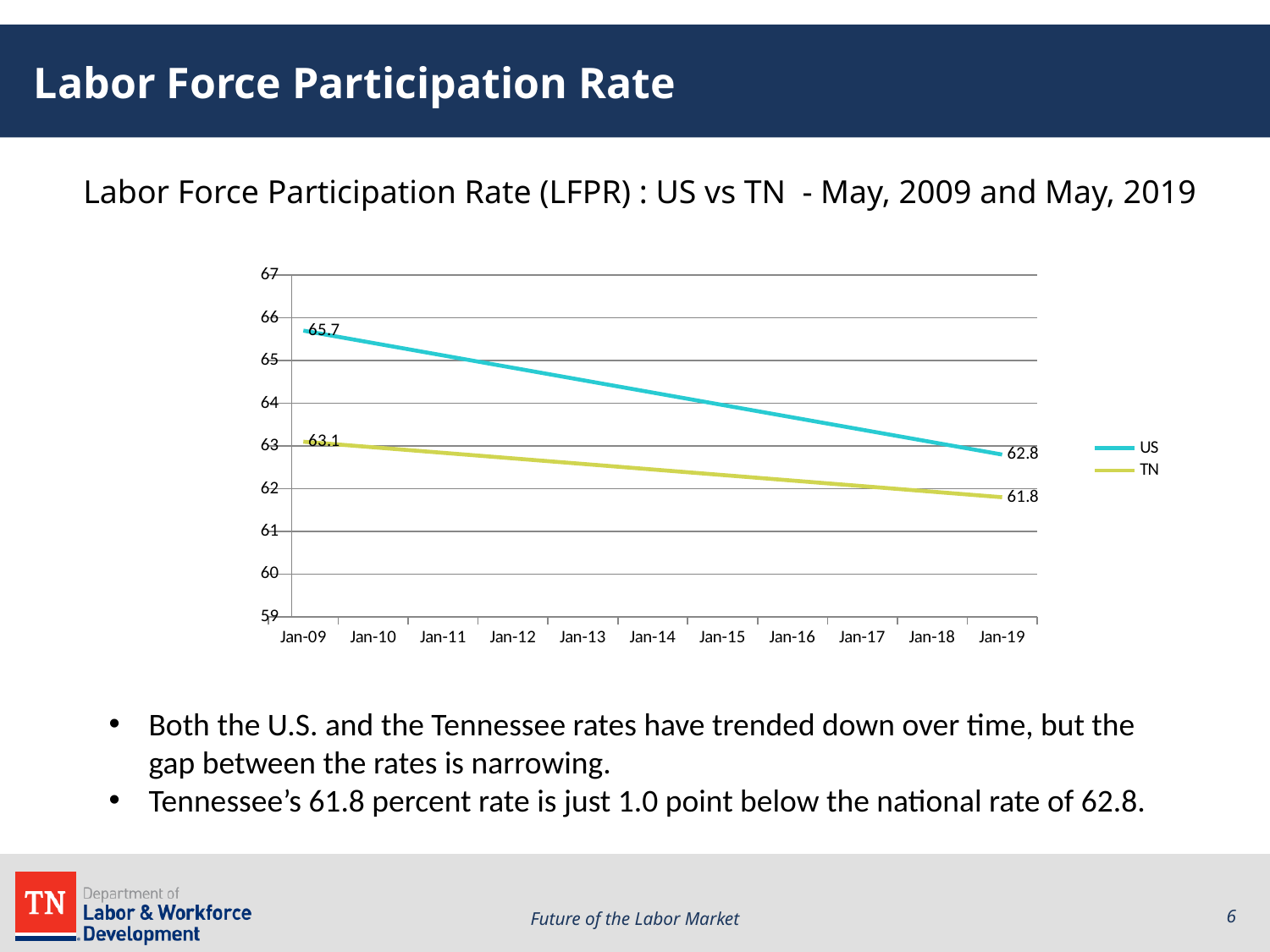
Does the US rate rise or fall from Jan-09 to Jan-19? fall What is the difference between the US and TN rates at Jan-19? 1.0 By how much did the US rate fall from Jan-09 to Jan-19? 2.9 What is the US labor force participation rate at Jan-09? 65.7 What is the TN labor force participation rate at Jan-09? 63.1 What is the US labor force participation rate at Jan-19? 62.8 Which series has the higher value at Jan-19, US or TN? US What colour is the US line in the chart? blue What is the TN labor force participation rate at Jan-19? 61.8 What is the difference between the US and TN rates at Jan-09? 2.6 How many series does the legend list? 2 What kind of chart is shown on the slide? line chart